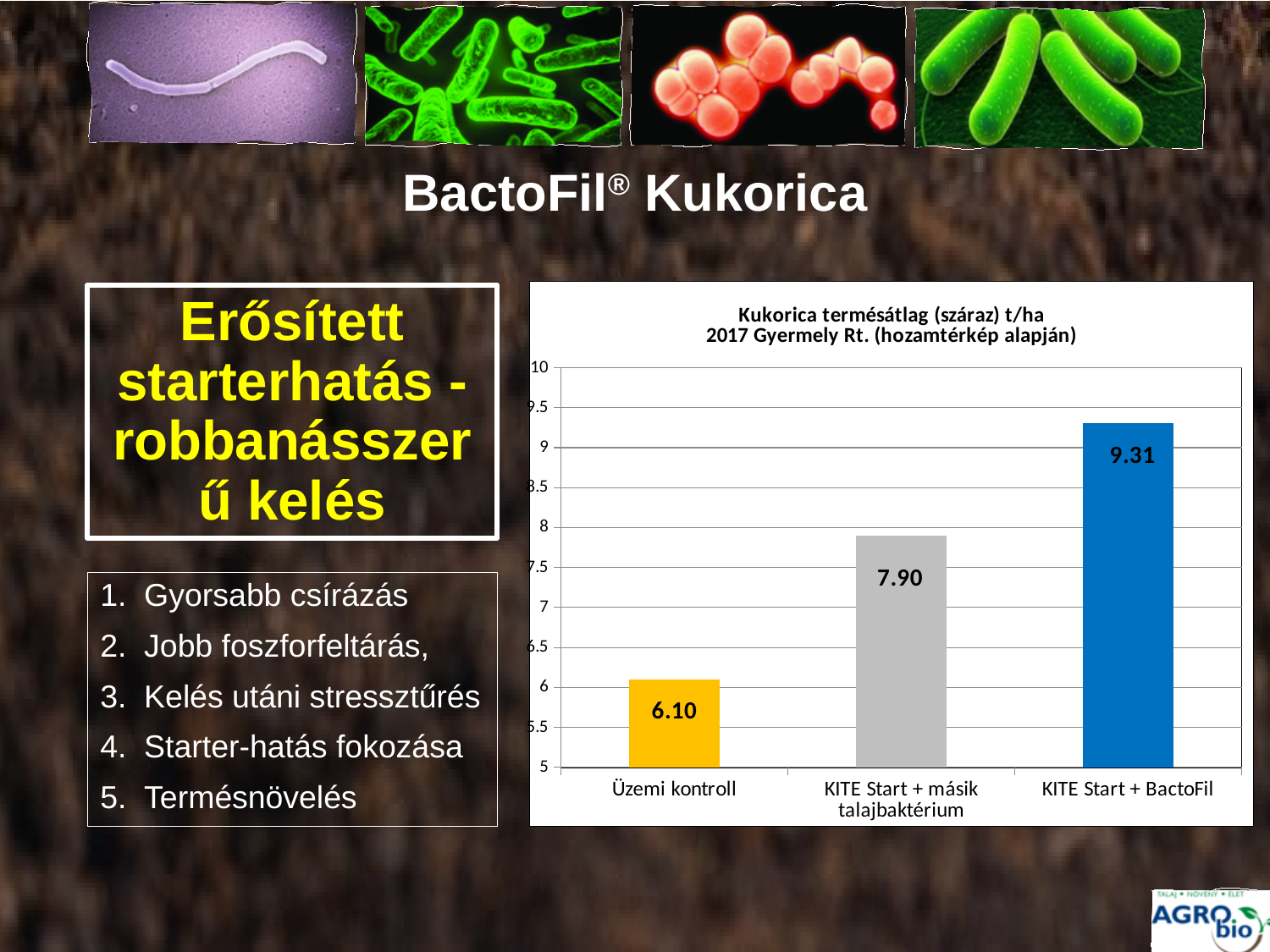
What is the value for KITE Start + BactoFil? 9.31 What kind of chart is shown on the slide? bar chart Which category has the highest value? KITE Start + BactoFil What is the title of the chart? Kukorica termésátlag (száraz) t/ha 2017 Gyermely Rt. (hozamtérkép alapján) Is the value for KITE Start + BactoFil greater or less than 9? greater What is the value for KITE Start + másik talajbaktérium? 7.90 What is the difference between the values for KITE Start + BactoFil and Üzemi kontroll? 3.21 What is the difference between the values for KITE Start + BactoFil and KITE Start + másik talajbaktérium? 1.41 What is the value for Üzemi kontroll? 6.10 Which is larger, the value for KITE Start + másik talajbaktérium or the value for Üzemi kontroll? KITE Start + másik talajbaktérium Which category has the lowest value? Üzemi kontroll How many categories are shown in the chart? 3